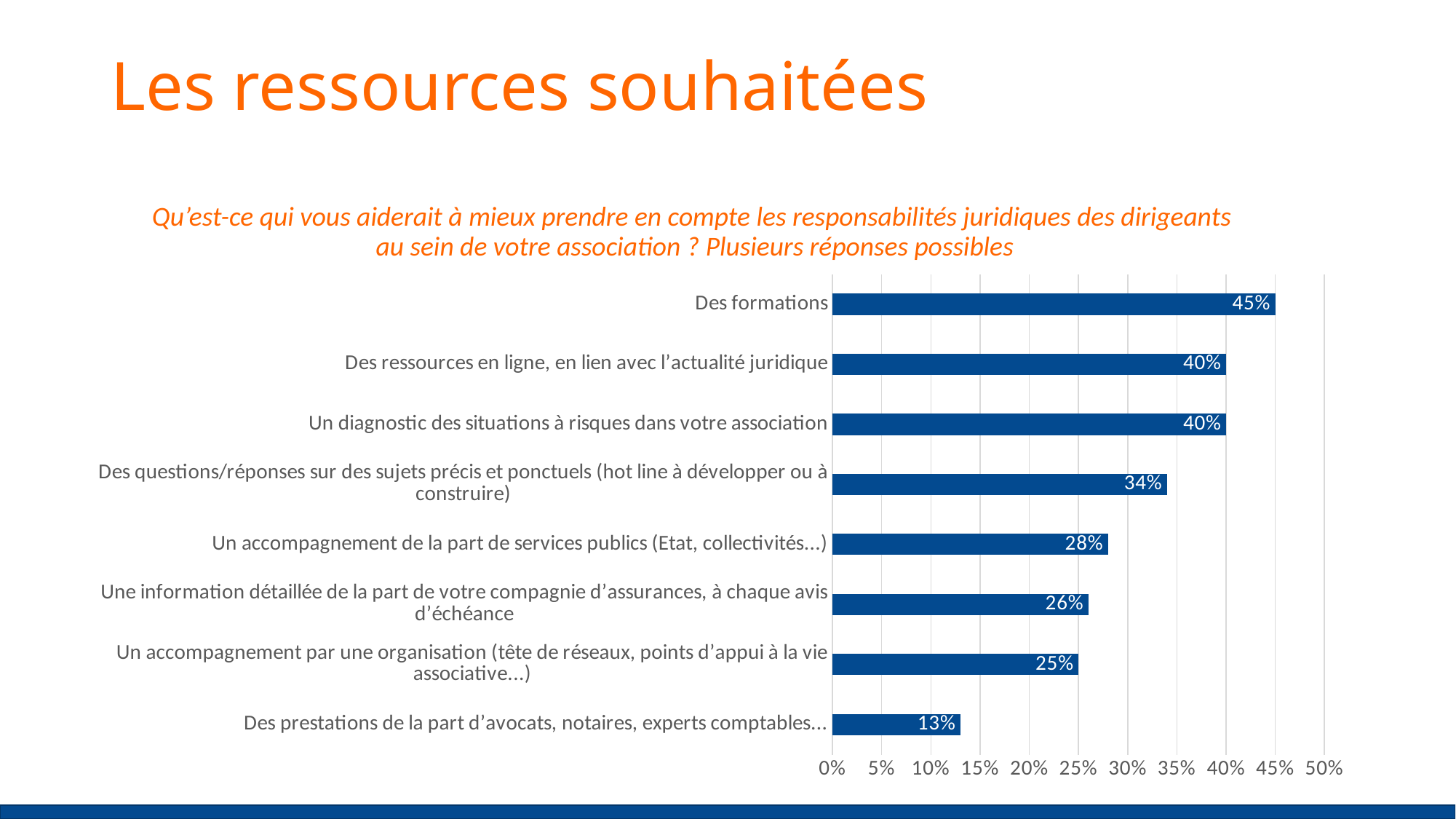
What is the value for "Des formations"? 45% Is the value for "Une information détaillée de la part de votre compagnie d'assurances, à chaque avis d'échéance" greater or less than 30%? less What kind of chart is shown on the slide? bar chart What is the value for "Un accompagnement de la part de services publics (Etat, collectivités…)"? 28% How many categories are shown in the chart? 8 Which category has the highest value? Des formations What is the value for "Des questions/réponses sur des sujets précis et ponctuels (hot line à développer ou à construire)"? 34% Which category has the lowest value? Des prestations de la part d'avocats, notaires, experts comptables… Which is larger: the value for "Un accompagnement de la part de services publics (Etat, collectivités…)" or the value for "Des questions/réponses sur des sujets précis et ponctuels (hot line à développer ou à construire)"? Des questions/réponses sur des sujets précis et ponctuels (hot line à développer ou à construire) What is the highest value shown on the x axis? 50% What is the value for "Des prestations de la part d'avocats, notaires, experts comptables…"? 13% What is the difference between the value for "Des formations" and the value for "Des prestations de la part d'avocats, notaires, experts comptables…"? 32%